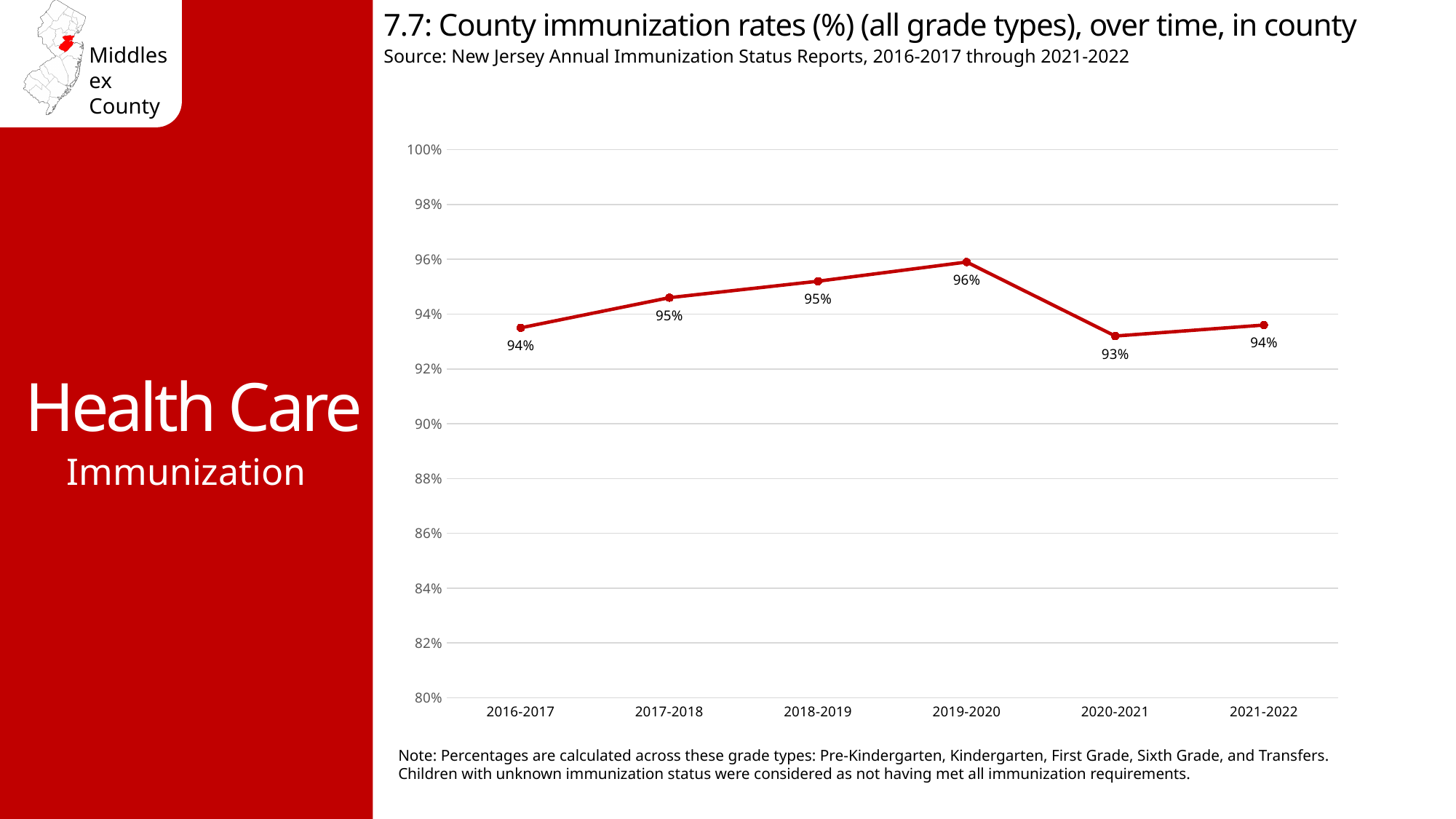
How many school years are plotted on the chart? 6 Which year had a higher immunization rate, 2019-2020 or 2020-2021? 2019-2020 What was the county immunization rate in 2018-2019? 95% Did the immunization rate rise or fall from 2016-2017 to 2019-2020? Rise What is the difference between the immunization rate in 2019-2020 and in 2020-2021? 3 percentage points Which school year had the lowest immunization rate? 2020-2021 What was the county immunization rate in 2016-2017? 94% Is the value for 2020-2021 greater or less than 94%? less What was the county immunization rate in 2020-2021? 93% What type of chart is shown on the slide? Line chart Which school year had the highest immunization rate? 2019-2020 What was the county immunization rate in 2019-2020? 96%